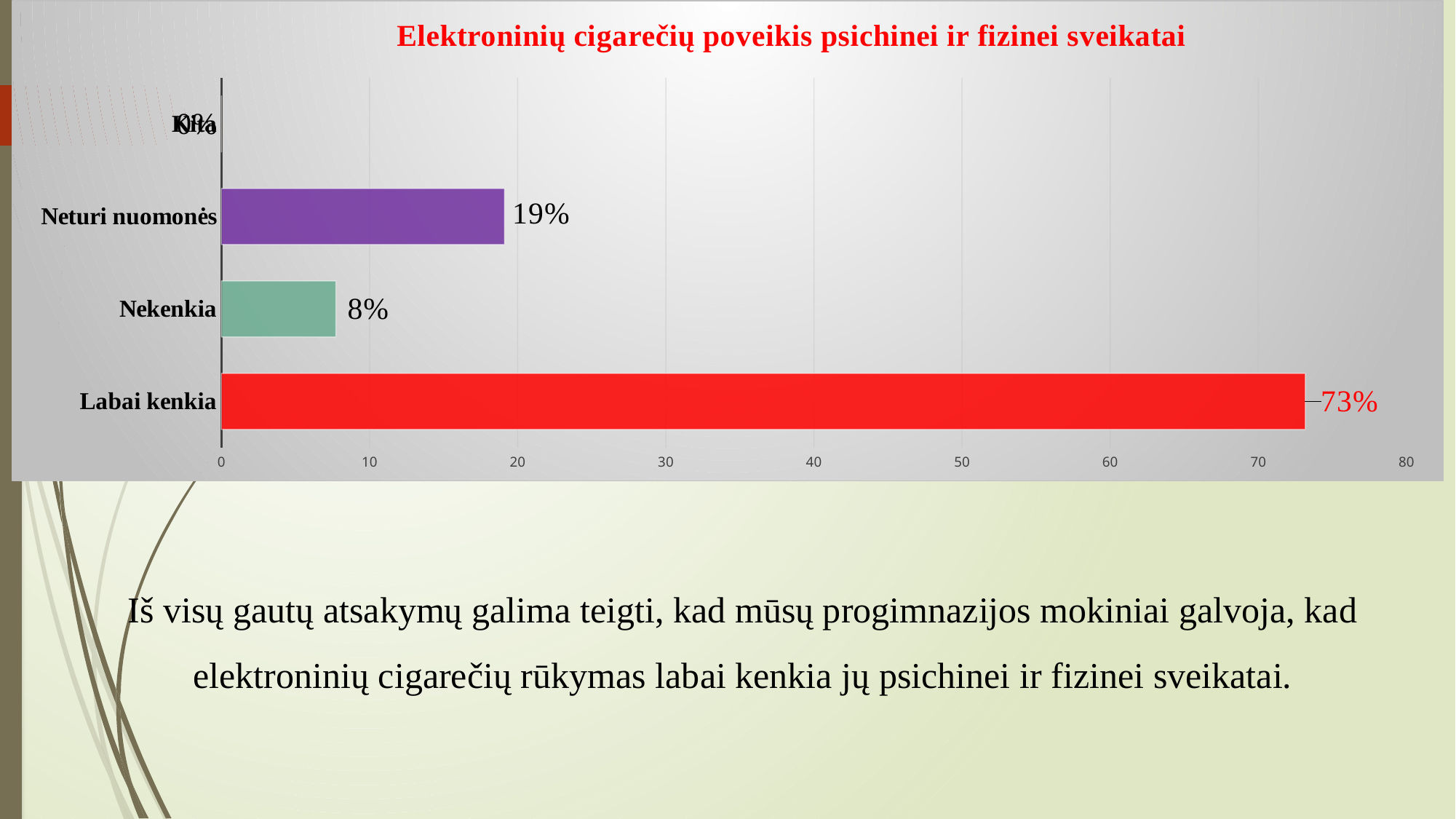
What is the value for Nekenkia? 8% What colour is the bar for Labai kenkia? red What kind of chart is shown on the slide? bar chart What is the difference between the values for Neturi nuomonės and Nekenkia? 11 percentage points Which category has the highest value? Labai kenkia What is the difference between the values for Labai kenkia and Neturi nuomonės? 54 percentage points Is the value for Labai kenkia greater or less than 70? greater What is the value for Labai kenkia? 73% What is the title of the chart? Elektroninių cigarečių poveikis psichinei ir fizinei sveikatai Is the value for Nekenkia greater or less than 10? less What is the value for Neturi nuomonės? 19% Which is larger, the value for Nekenkia or the value for Neturi nuomonės? Neturi nuomonės